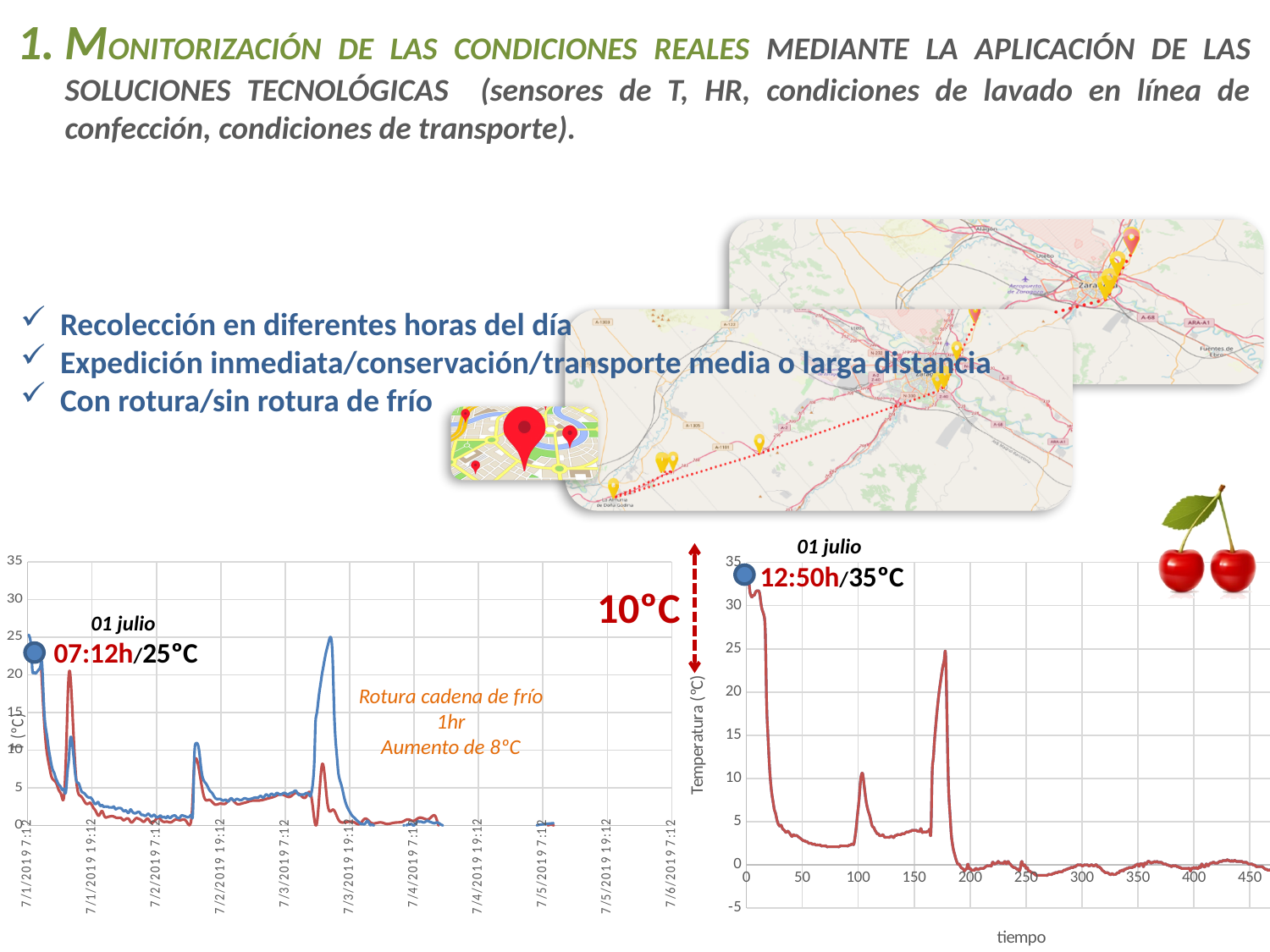
What kind of chart is the chart on the left (with dates on the x axis)? line chart On the left chart, what temperature is annotated at the starting point on 01 julio at 07:12h? 25°C On the left chart, is the peak of the blue line around 7/3/2019 greater or less than 20? greater On the right chart, what temperature is annotated at the starting point on 01 julio at 12:50h? 35°C On the right chart, is the value at x = 300 greater or less than 5? less What is the difference between the annotated starting temperatures of the right chart (35°C) and the left chart (25°C)? 10°C On the left chart, how many data series (lines) are plotted? 2 On the right chart, what is the label of the y axis? Temperatura (°C) Which chart has the higher annotated starting temperature, the left chart or the right chart? the right chart On the right chart, what is the label of the x axis? tiempo What kind of chart is the chart on the right (with 'tiempo' on the x axis)? line chart On the right chart, is the peak value near x = 100 greater or less than 5? greater